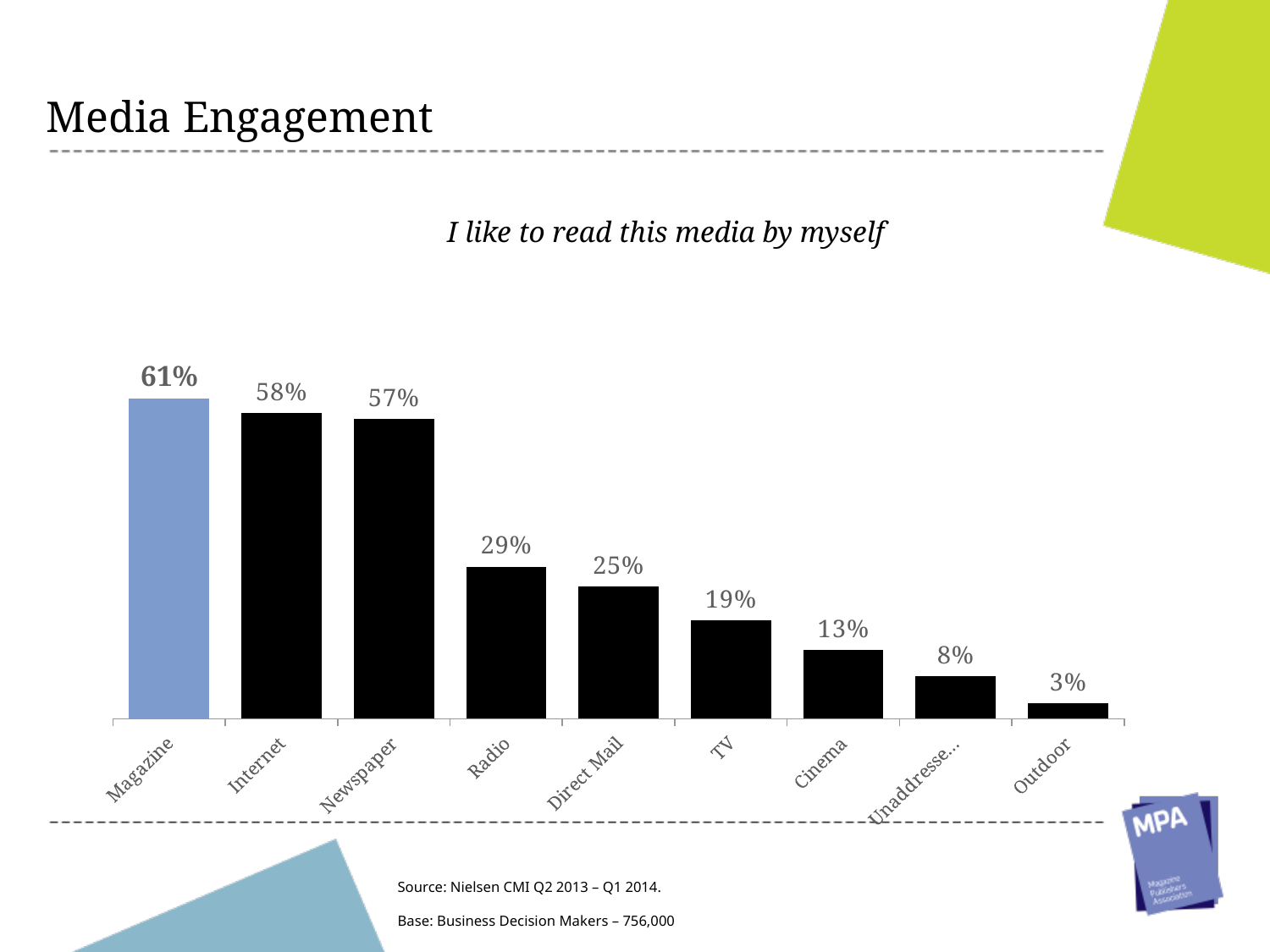
What is the value for Cinema? 13% Which is larger, the value for Direct Mail or the value for Cinema? Direct Mail What is the value for Radio? 29% What is the difference between the values for Radio and TV? 10% Which category has the lowest value? Outdoor How many categories are shown on the chart? 9 Which bar is shown in a different colour (blue) from the others? Magazine Which category has the highest value? Magazine Do the values rise or fall from left to right along the x axis? Fall What is the value for Magazine? 61% What is the difference between the values for Magazine and Internet? 3% What kind of chart is shown on the slide? Bar chart